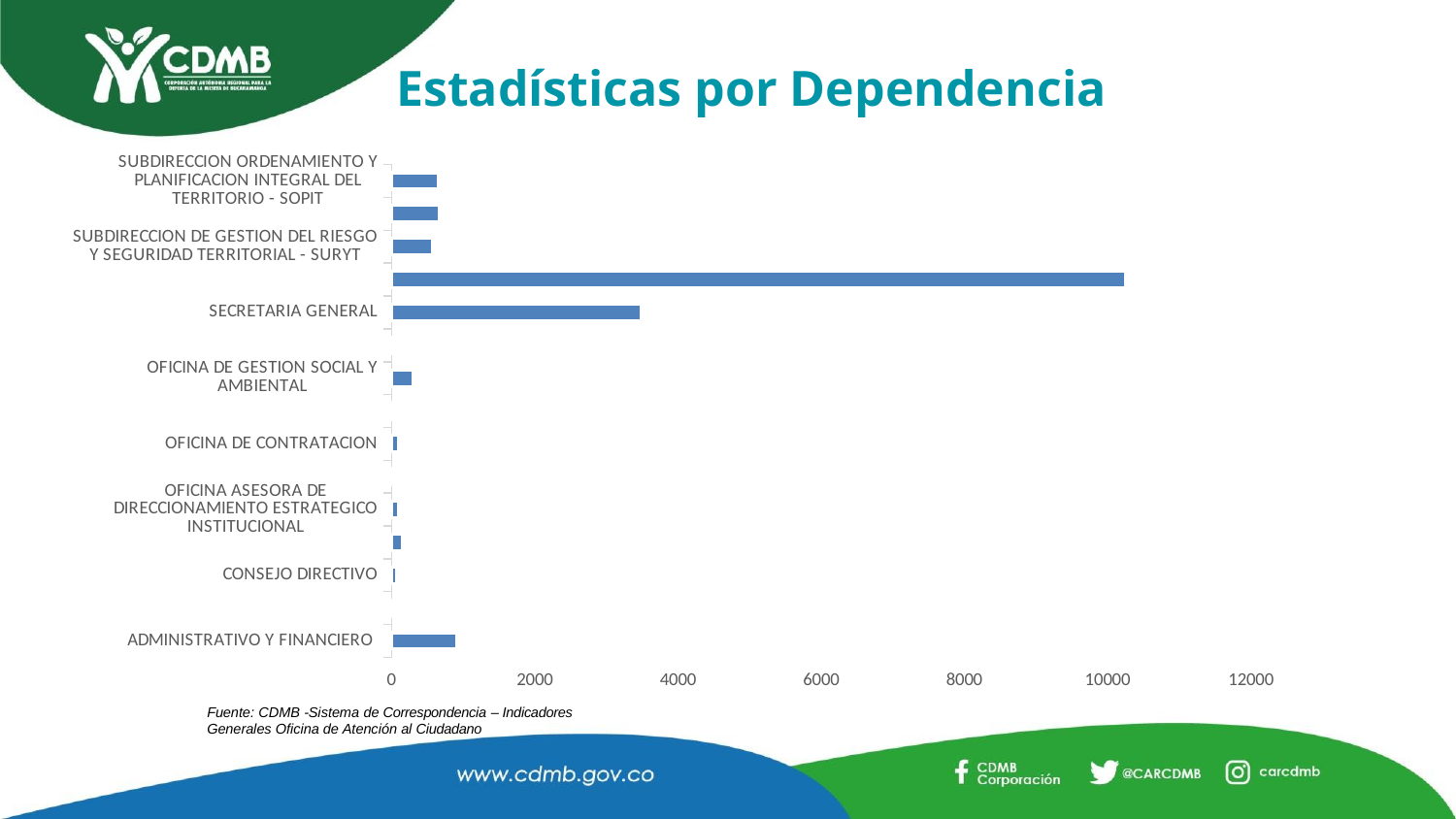
Which has the larger value, ADMINISTRATIVO Y FINANCIERO or CONSEJO DIRECTIVO? ADMINISTRATIVO Y FINANCIERO Is the value for OFICINA DE GESTION SOCIAL Y AMBIENTAL greater or less than 2000? less What kind of chart is shown on the slide? bar chart Which has the larger value, SUBDIRECCION ORDENAMIENTO Y PLANIFICACION INTEGRAL DEL TERRITORIO - SOPIT or OFICINA DE GESTION SOCIAL Y AMBIENTAL? SUBDIRECCION ORDENAMIENTO Y PLANIFICACION INTEGRAL DEL TERRITORIO - SOPIT What is the highest value shown on the horizontal axis? 12000 What is the title of the chart? Estadísticas por Dependencia Is the value for ADMINISTRATIVO Y FINANCIERO greater or less than 2000? less Which has the larger value, SECRETARIA GENERAL or ADMINISTRATIVO Y FINANCIERO? SECRETARIA GENERAL Is the value for SECRETARIA GENERAL greater or less than 4000? less How many category labels are shown on the vertical axis of the chart? 8